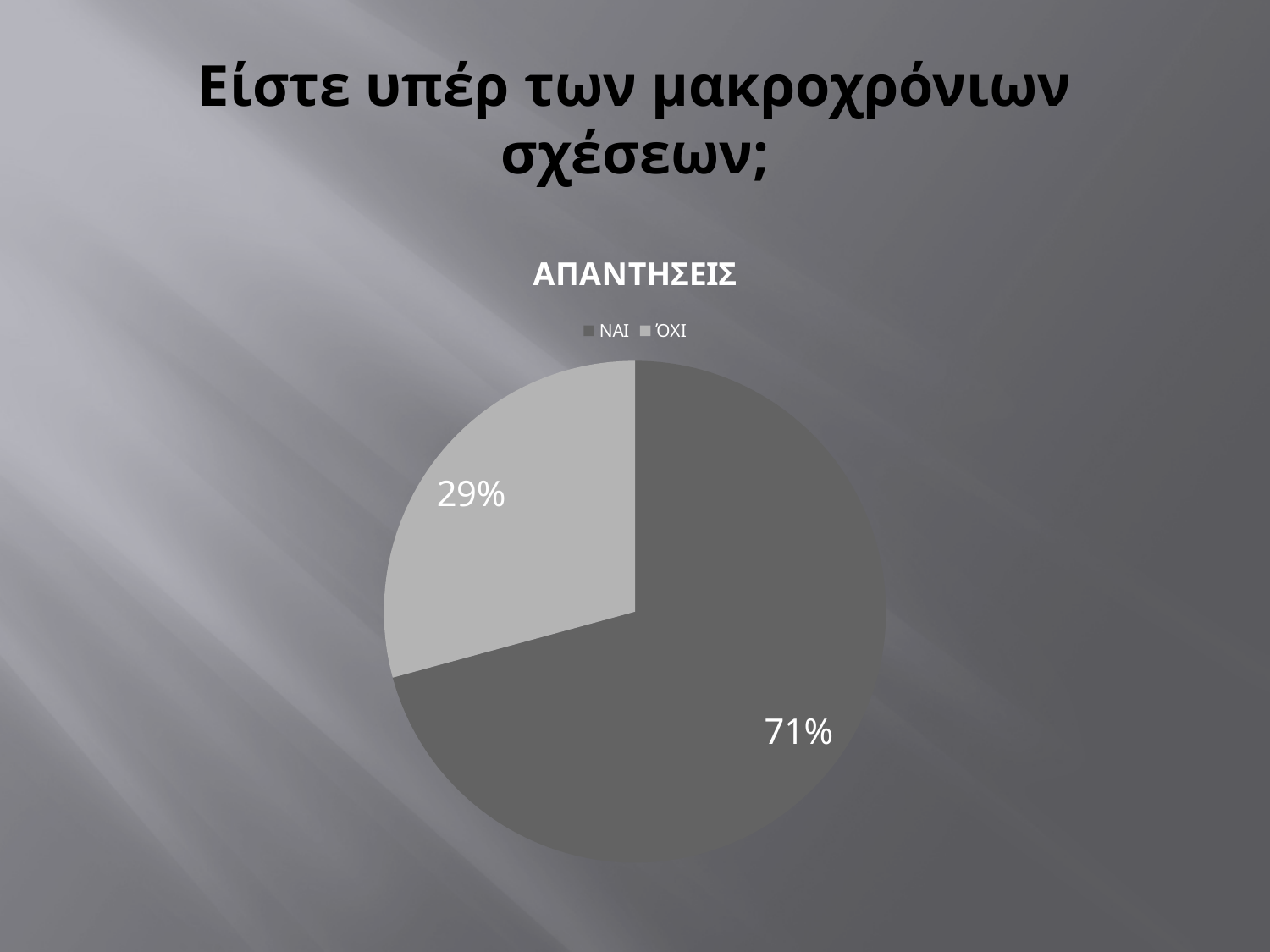
What is the chart's title? ΑΠΑΝΤΗΣΕΙΣ What share of the pie does ΝΑΙ take? 71% What kind of chart is shown on the slide? pie chart How many slices does the pie chart have? 2 Which is larger, ΝΑΙ or ΌΧΙ? ΝΑΙ Which slice is the largest? ΝΑΙ What share of the pie does ΌΧΙ take? 29% What is the difference between the ΝΑΙ and ΌΧΙ shares? 42% Which slice is the smallest? ΌΧΙ Which legend entry is shown in the lighter grey colour? ΌΧΙ How many entries does the legend list? 2